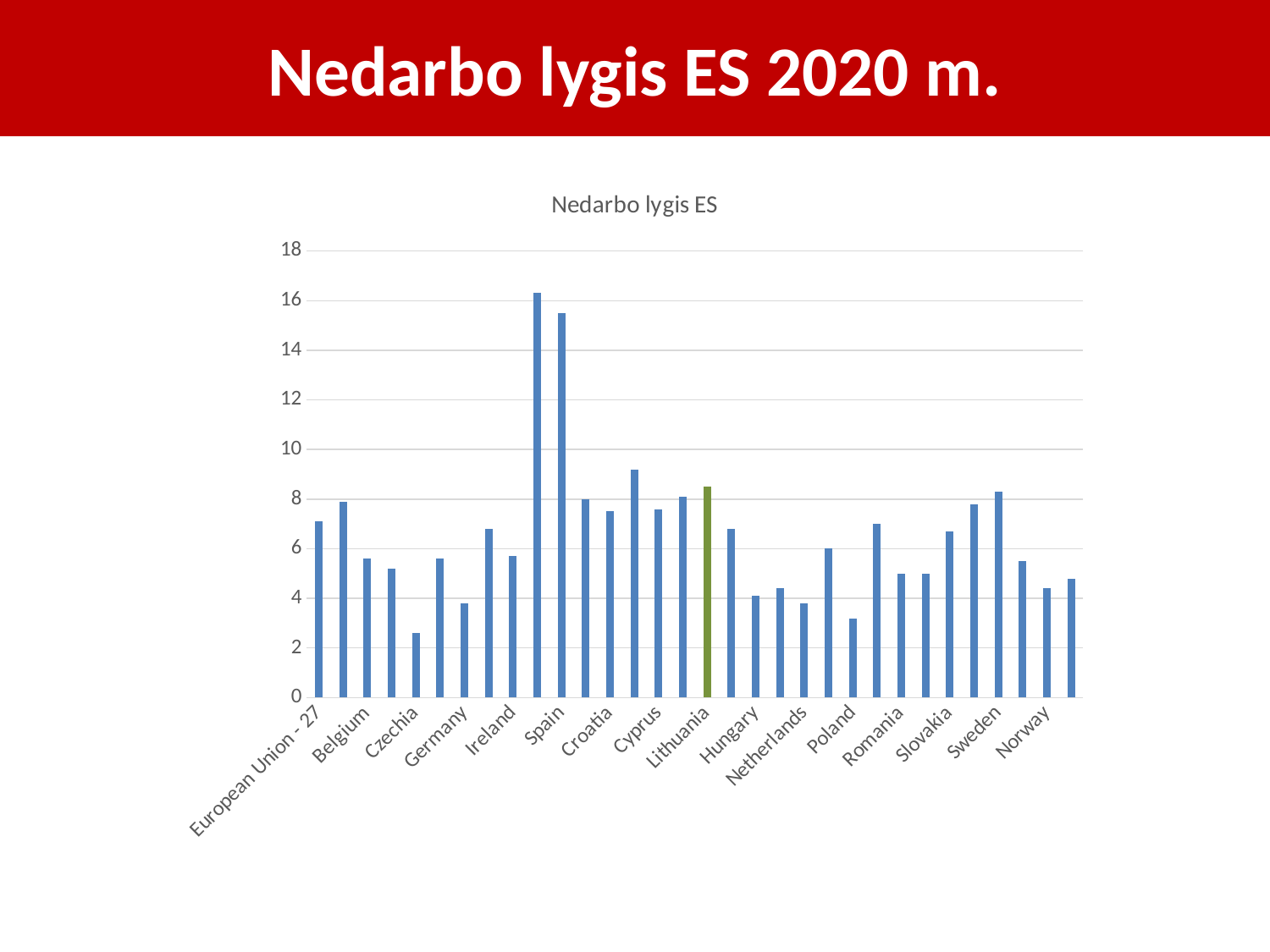
Is the value for Czechia greater or less than 4? less Among the labelled countries, which has the lowest value? Czechia Which is larger, the value for Spain or the value for Croatia? Spain Is the value for Poland greater or less than 4? less What type of chart is shown on the slide? bar chart Is the value for Spain greater or less than 14? greater Which is larger, the value for Lithuania or the value for Hungary? Lithuania How many bars are plotted in the chart? 32 What is the title of the chart? Nedarbo lygis ES Which country's bar is coloured green instead of blue? Lithuania